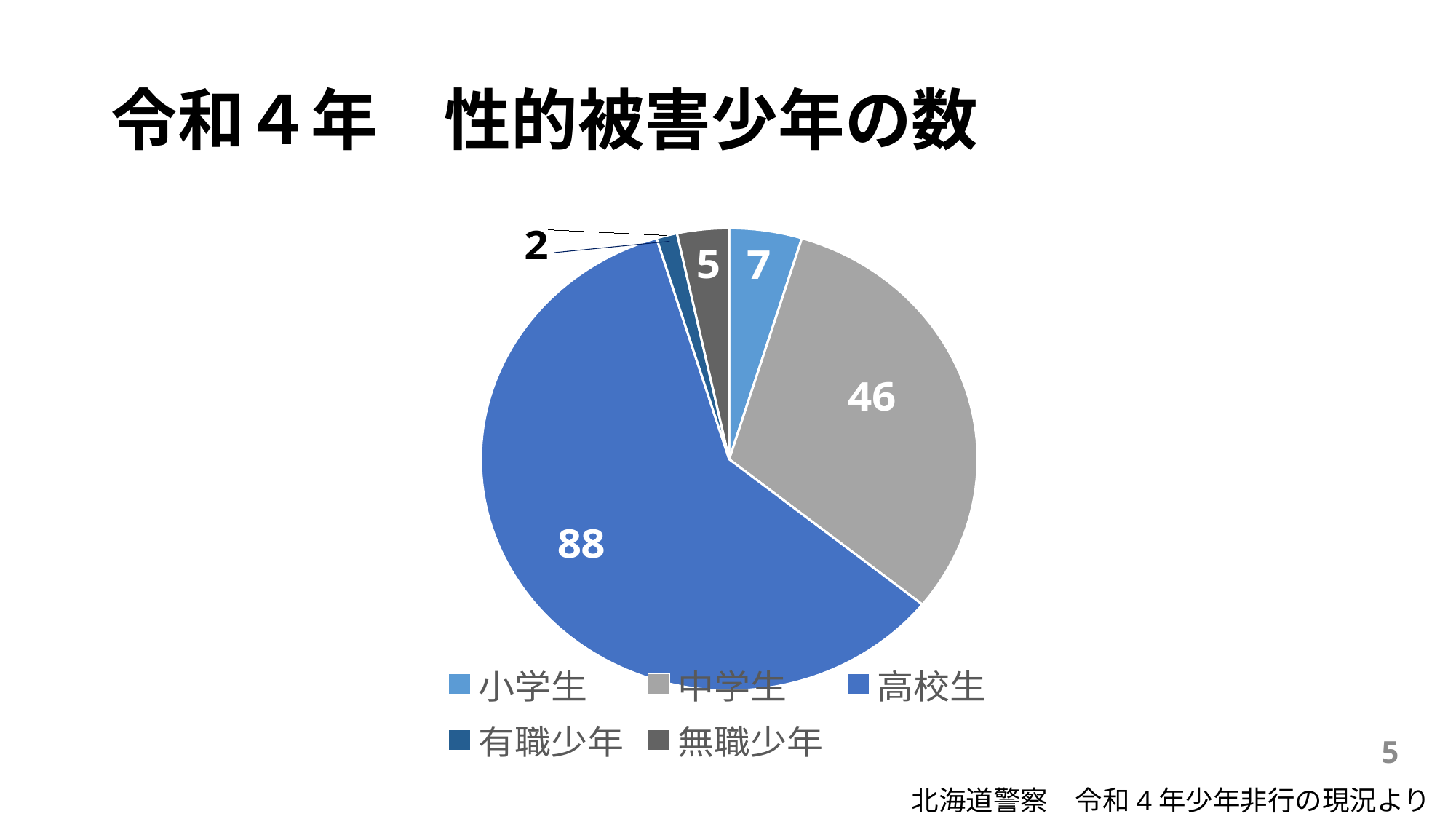
What is the total of all the values shown in the pie chart? 148 Which is larger, the value for 小学生 or the value for 無職少年? 小学生 What type of chart is shown on the slide? pie chart What is the value for 小学生 in the pie chart? 7 What is the difference between the values for 高校生 and 中学生? 42 Which category has the largest slice of the pie chart? 高校生 What is the value for 無職少年 in the pie chart? 5 Which category has the smallest slice of the pie chart? 有職少年 What is the value for 有職少年 in the pie chart? 2 What is the value for 中学生 in the pie chart? 46 How many categories does the pie chart have? 5 What is the value for 高校生 in the pie chart? 88